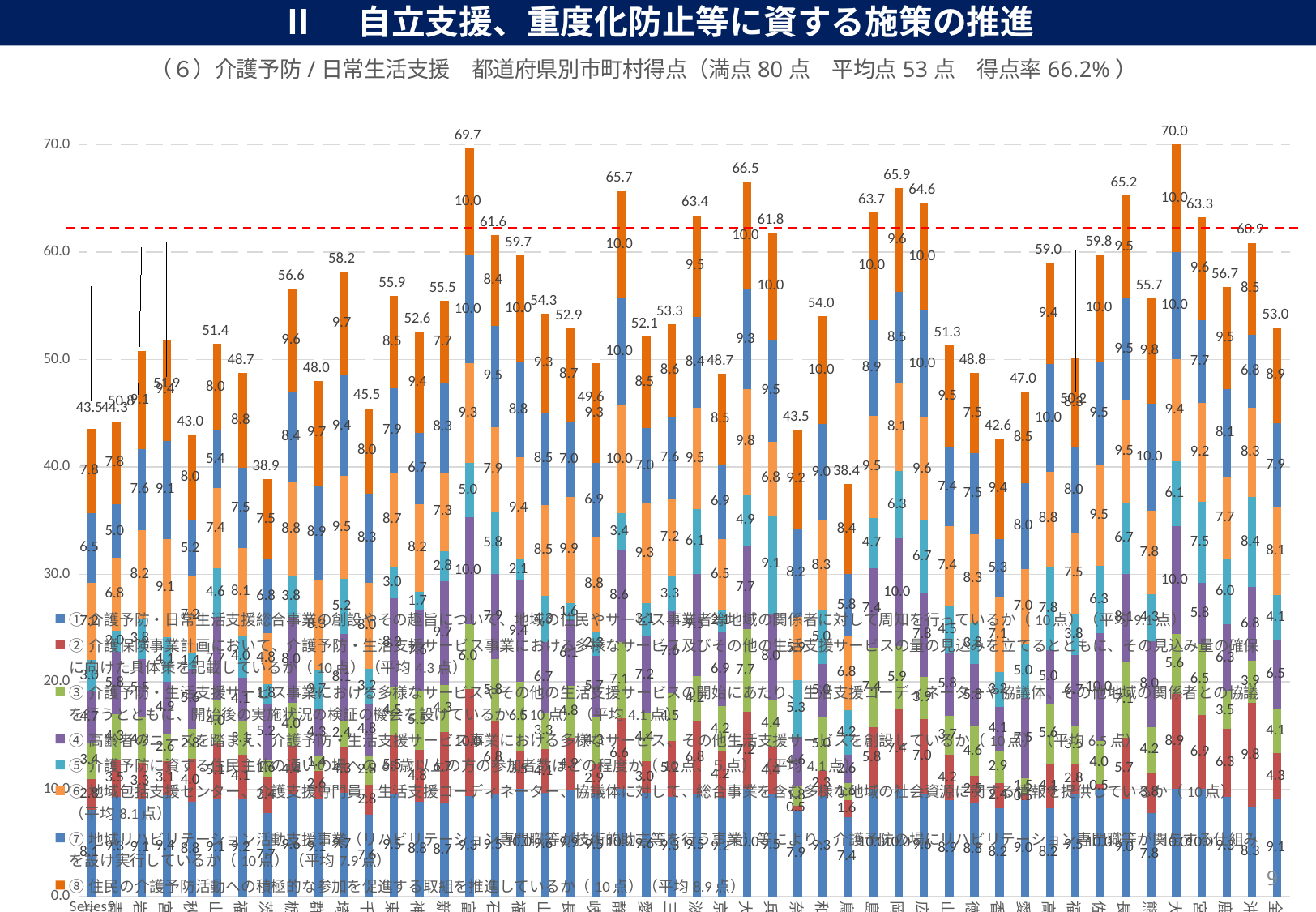
How many series does the legend list? 9 What is the difference between the two highest bar totals, 70.0 and 69.7? 0.3 Which is larger, the bar total of 69.7 or the bar total of 66.5? 69.7 What is the lowest total score shown on top of any bar? 38.4 What is the difference between the highest bar total (70.0) and the lowest bar total (38.4)? 31.6 According to the subtitle, what is the average score (平均点) and the score rate (得点率)? 53 点, 66.2% According to the subtitle, what is the maximum possible score (満点)? 80 点 Is the lowest bar total greater or less than 40? less What kind of chart is shown on the slide? stacked bar chart What is the highest total score shown on top of any bar? 70.0 What is the second-highest total score labelled on the bars? 69.7